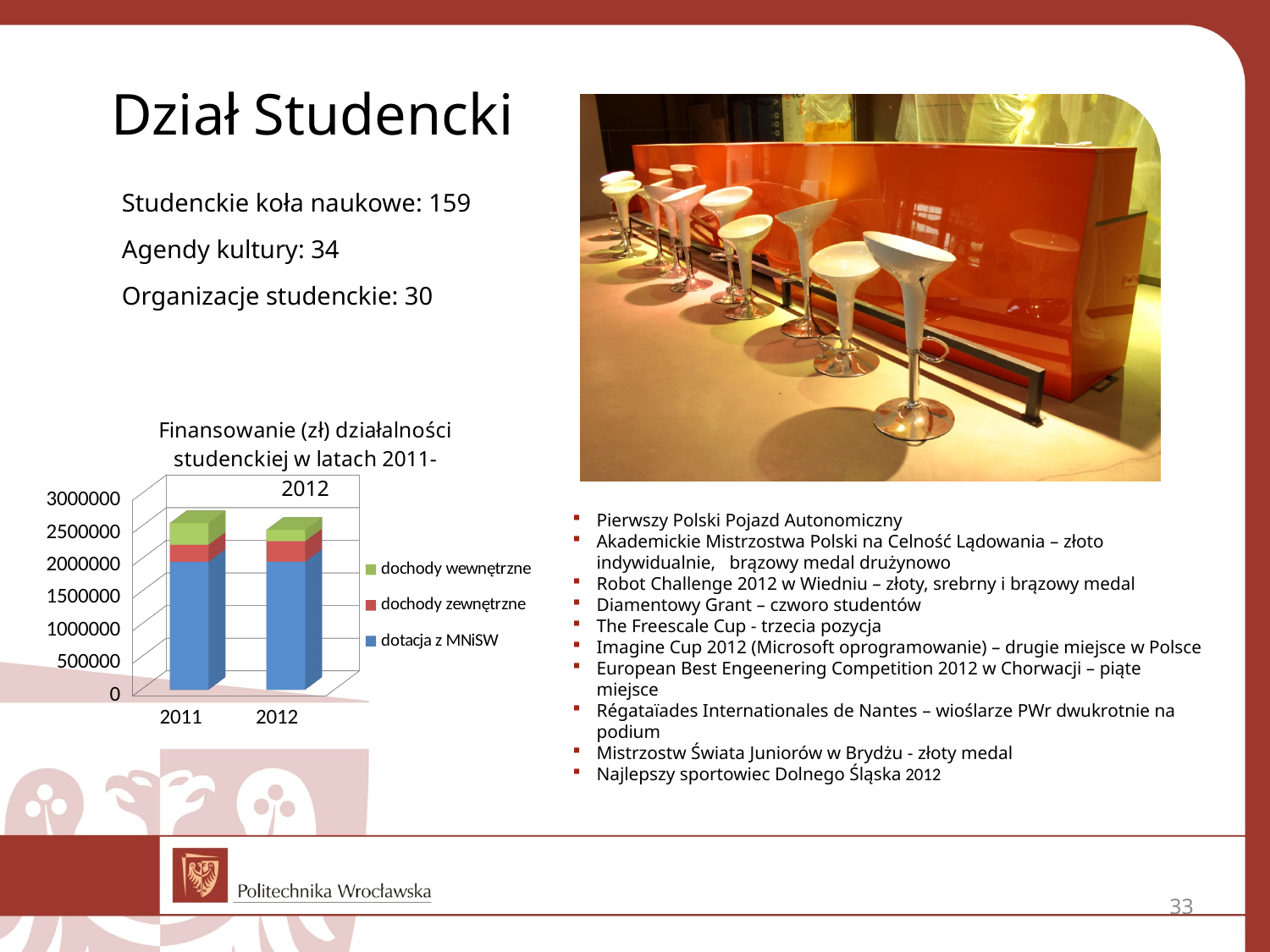
How many years (categories) are shown on the x axis of the chart? 2 Is the value of dotacja z MNiSW for 2012 greater or less than 1000000? greater Is the total height of the 2011 bar greater or less than 2000000? greater How many series does the chart's legend list? 3 Which series forms the bottom segment of each stacked bar in the chart? dotacja z MNiSW Is the total height of the 2012 bar greater or less than 3000000? less Which year has the taller stacked bar in the chart, 2011 or 2012? 2011 Which series is shown in blue in the chart? dotacja z MNiSW What kind of chart is shown on the slide? bar chart What is the title of the chart on the slide? Finansowanie (zł) działalności studenckiej w latach 2011-2012 Does the total funding rise or fall from 2011 to 2012 in the chart? fall